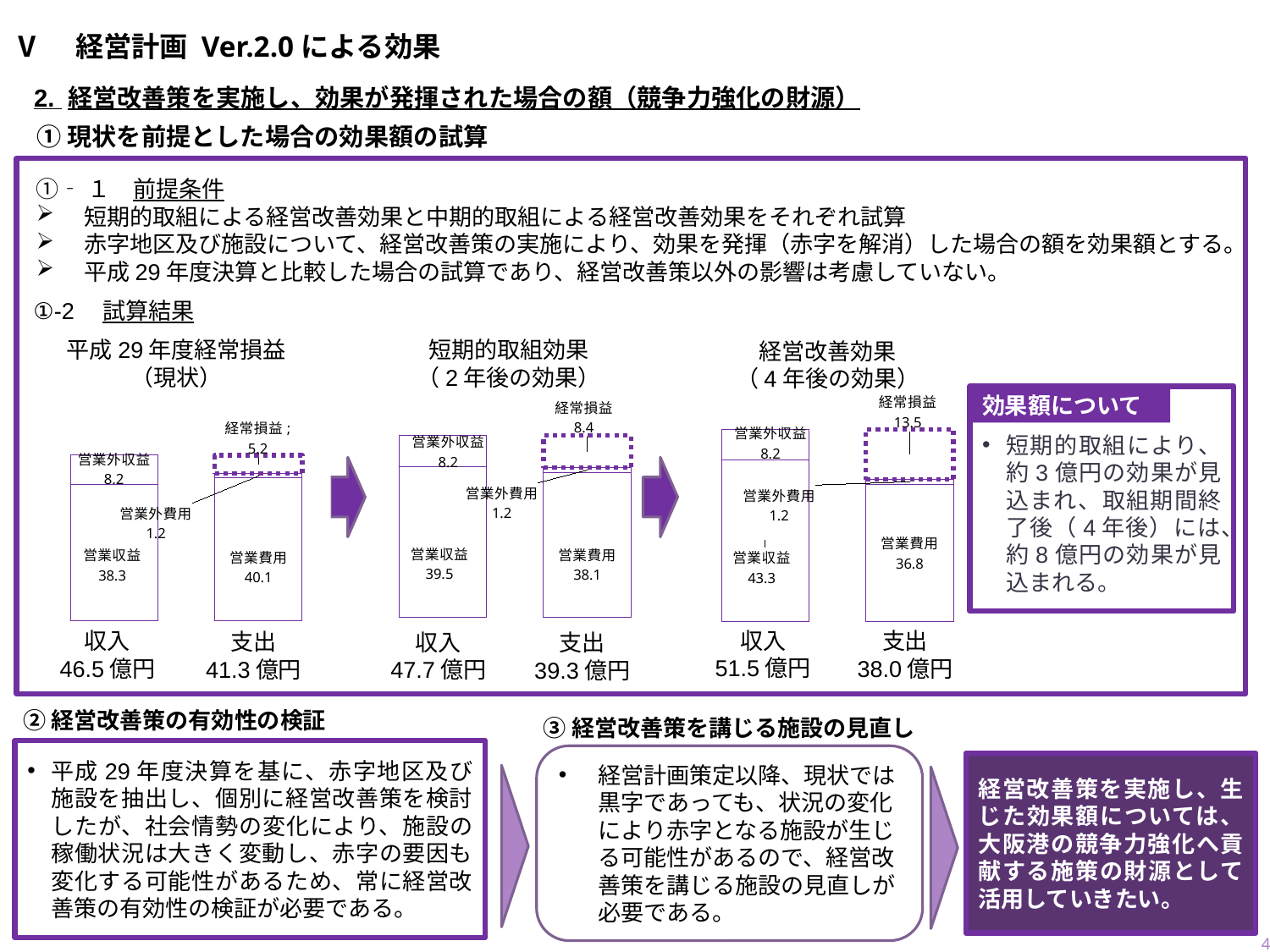
「短期的取組効果（2年後の効果）」の図で、営業収益と営業費用ではどちらが大きいですか？ 営業収益 「平成29年度経常損益（現状）」の図で、収入の合計額はいくらですか？ 46.5億円 3つの図のうち、支出の合計額が最も小さいのはどれですか？ 経営改善効果（4年後の効果） 3つの図のうち、経常損益が最も大きいのはどれですか？ 経営改善効果（4年後の効果） 「経営改善効果（4年後の効果）」の図で、収入と支出の差はいくらですか？ 13.5億円 この図はどのような種類のグラフですか？ 積み上げ棒グラフ 「経営改善効果（4年後の効果）」の図で、支出の合計額はいくらですか？ 38.0億円 「平成29年度経常損益（現状）」の図で、営業費用の値はいくらですか？ 40.1 「短期的取組効果（2年後の効果）」の図で、経常損益の値はいくらですか？ 8.4 「平成29年度経常損益（現状）」の図で、営業外収益と営業収益を合計するといくらになりますか？ 46.5 現状から4年後にかけて、収入の合計額は増加していますか、減少していますか？ 増加 「経営改善効果（4年後の効果）」の図で、営業収益の値はいくらですか？ 43.3